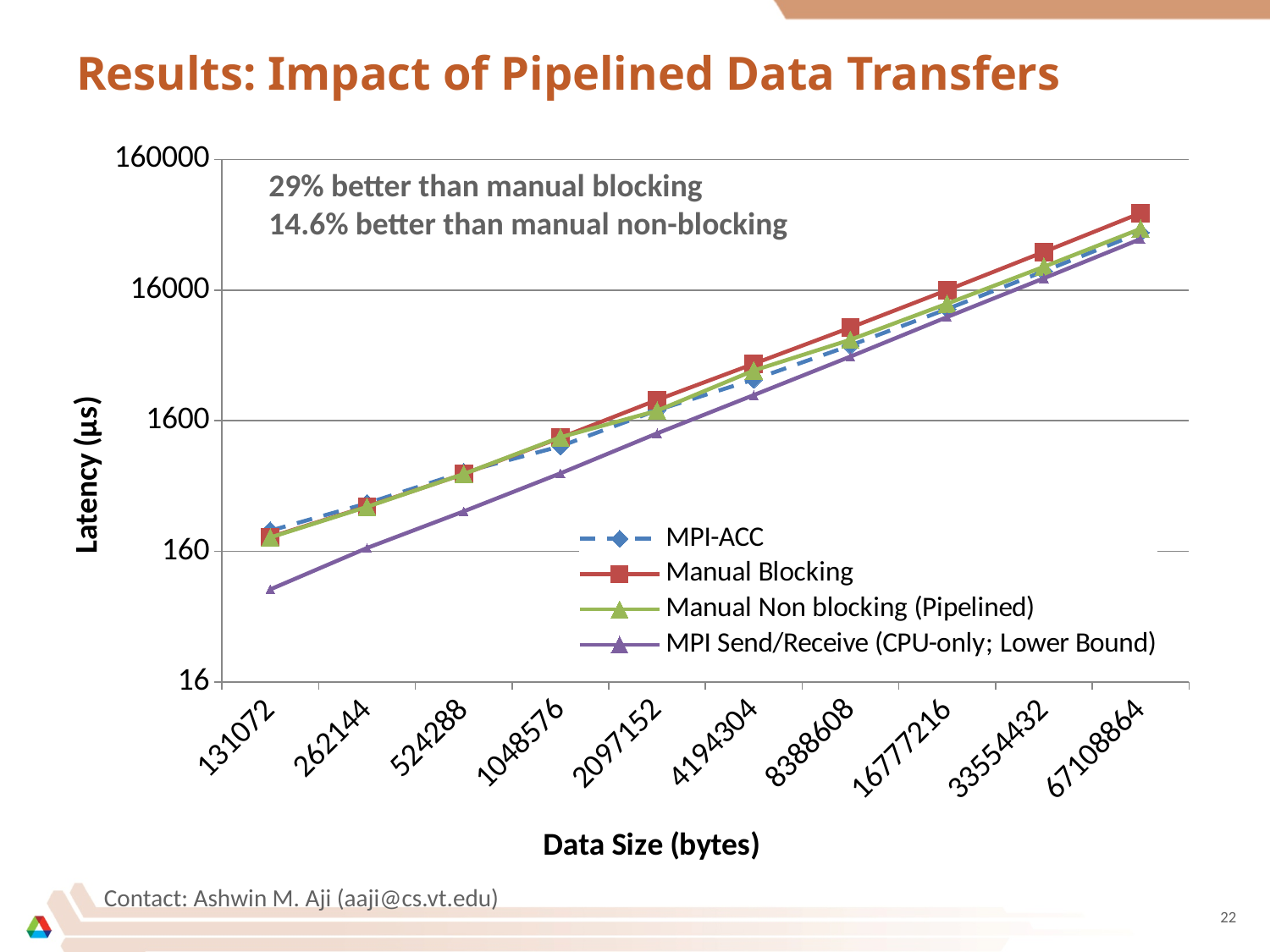
At a data size of 131072 bytes, which has the larger latency: Manual Blocking or MPI Send/Receive (CPU-only; Lower Bound)? Manual Blocking What is the label of the y axis? Latency (µs) Which series has the highest latency at a data size of 67108864 bytes? Manual Blocking Is the latency for MPI Send/Receive (CPU-only; Lower Bound) at 131072 bytes greater or less than 160? less Is the latency for MPI Send/Receive (CPU-only; Lower Bound) at 1048576 bytes greater or less than 1600? less How many data size categories are shown on the x axis? 10 How many series does the legend list? 4 Does the latency for Manual Blocking rise or fall as data size increases along the x axis? rise Is the latency for Manual Blocking at 131072 bytes greater or less than 160? greater Which series has the lowest latency at a data size of 131072 bytes? MPI Send/Receive (CPU-only; Lower Bound) What kind of chart is shown on the slide? line chart